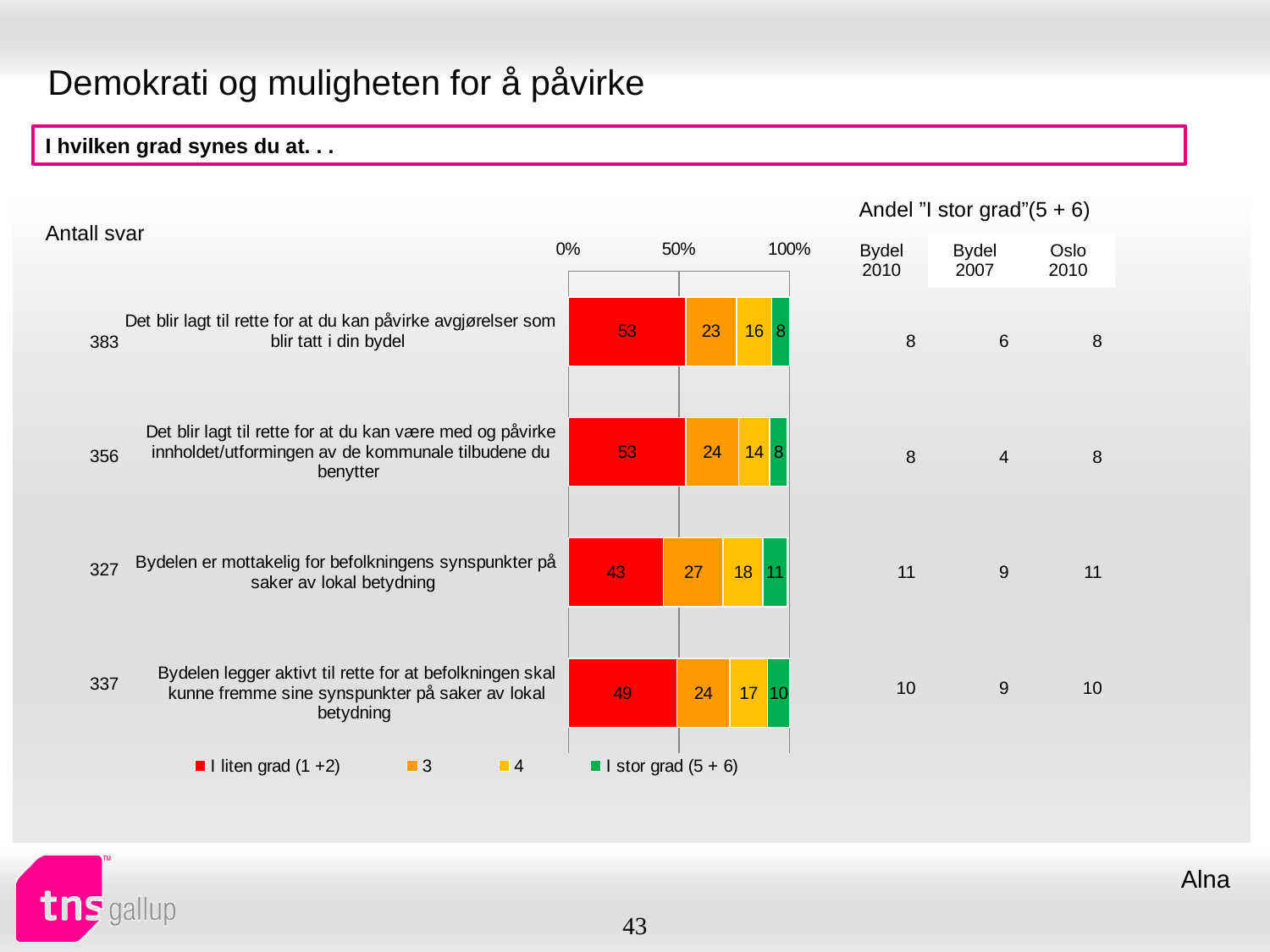
How many series does the legend list? 4 What is the total of the stacked bar for "Bydelen er mottakelig for befolkningens synspunkter på saker av lokal betydning"? 99 What is the value of series "3" for "Det blir lagt til rette for at du kan være med og påvirke innholdet/utformingen av de kommunale tilbudene du benytter"? 24 What is the value of series "4" for "Det blir lagt til rette for at du kan påvirke avgjørelser som blir tatt i din bydel"? 16 Which category has the highest value for "I stor grad (5 + 6)"? Bydelen er mottakelig for befolkningens synspunkter på saker av lokal betydning What kind of chart is shown on the slide? Stacked bar chart What is the value of "I stor grad (5 + 6)" for "Bydelen legger aktivt til rette for at befolkningen skal kunne fremme sine synspunkter på saker av lokal betydning"? 10 Which category has the lowest value for "I liten grad (1 +2)"? Bydelen er mottakelig for befolkningens synspunkter på saker av lokal betydning What is the difference between the "I liten grad (1 +2)" values for "Det blir lagt til rette for at du kan påvirke avgjørelser som blir tatt i din bydel" and "Bydelen er mottakelig for befolkningens synspunkter på saker av lokal betydning"? 10 Which is larger: the "3" value for "Bydelen er mottakelig for befolkningens synspunkter på saker av lokal betydning" or the "3" value for "Bydelen legger aktivt til rette for at befolkningen skal kunne fremme sine synspunkter på saker av lokal betydning"? Bydelen er mottakelig for befolkningens synspunkter på saker av lokal betydning How many categories does the chart show? 4 What is the value of "I liten grad (1 +2)" for "Bydelen er mottakelig for befolkningens synspunkter på saker av lokal betydning"? 43